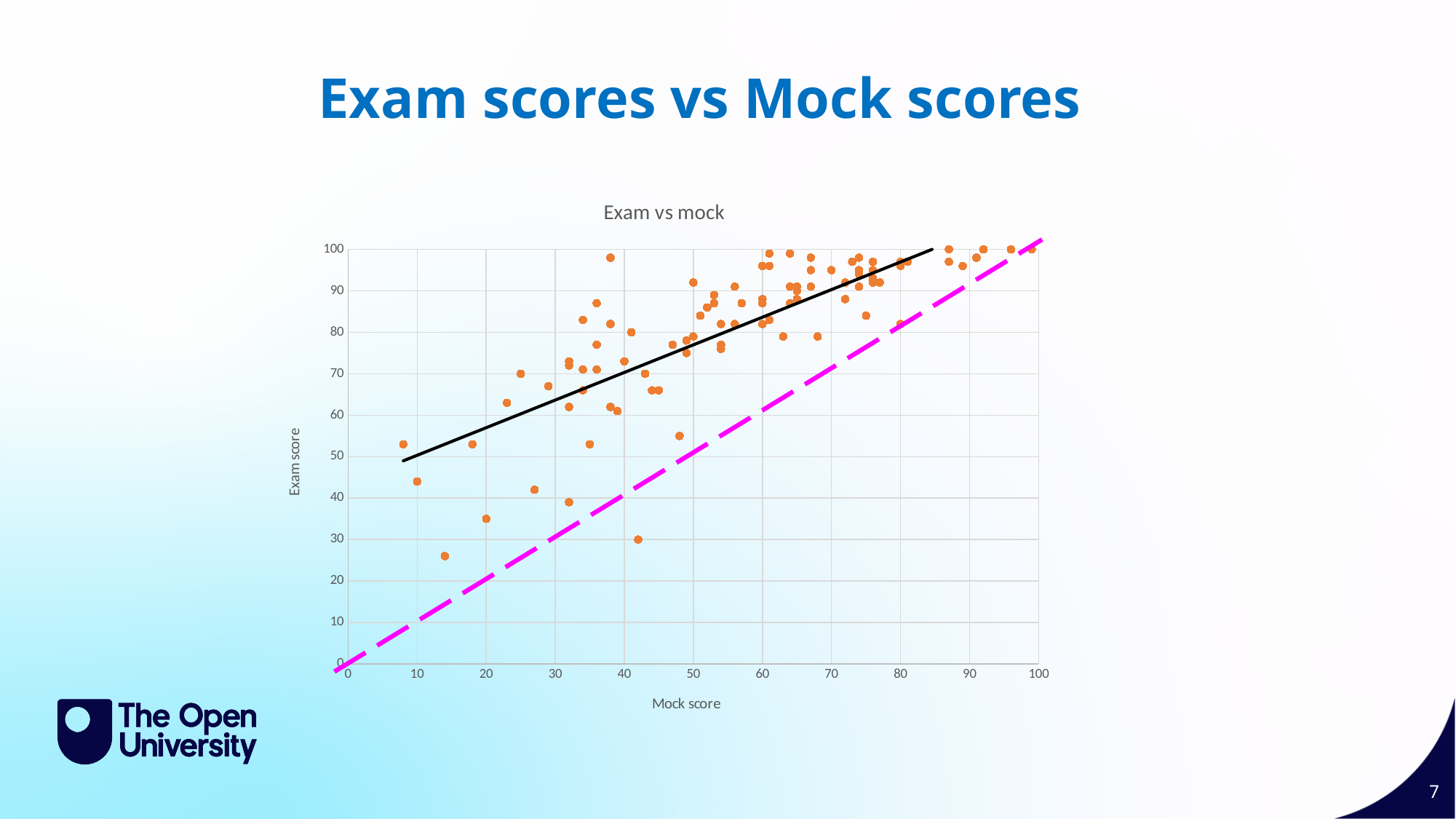
Is the lowest plotted exam score greater or less than 30? less What label is shown on the horizontal axis of the chart? Mock score Does the solid black trend line lie above or below the magenta dashed line? Above What is the highest value shown on the vertical axis? 100 Is the highest plotted mock score greater or less than 90? greater What is the highest value shown on the horizontal axis? 100 What kind of chart is shown on the slide? Scatter chart What is the title of the chart? Exam vs mock As mock scores increase along the x axis, do exam scores generally rise or fall? Rise